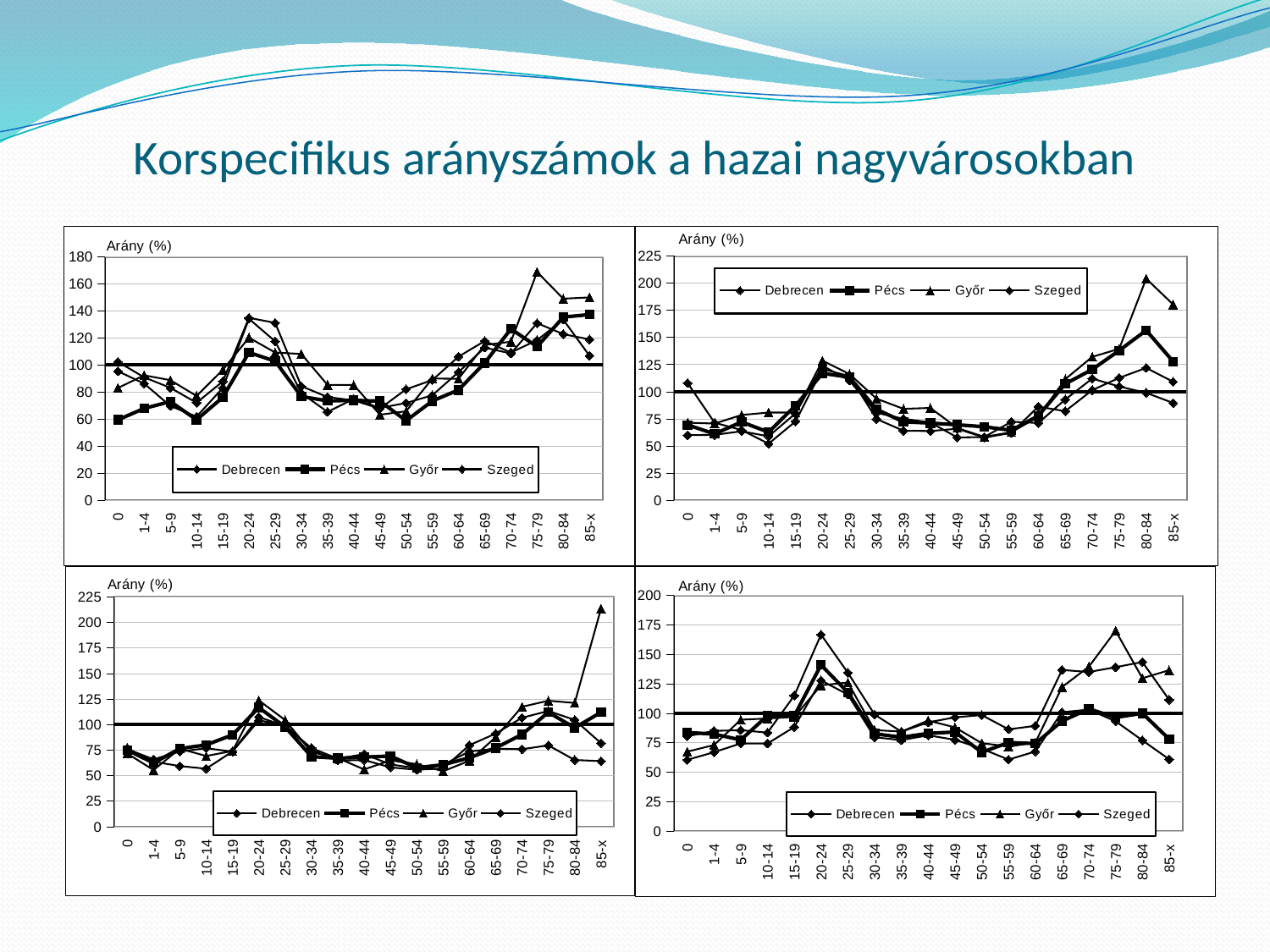
What is the y-axis label of the bottom-right chart? Arány (%) In the top-right chart, is the value for Győr at 80-84 greater or less than 175? greater In the bottom-left chart, which series has the highest value at 85-x? Győr In the top-right chart, which series has the highest value at 80-84? Győr In the top-left chart, which series has the highest value at 75-79? Győr What type of chart is the top-left chart? line chart In the top-left chart, is the value for Győr at 75-79 greater or less than 160? greater In the bottom-left chart, is the value for Győr at 85-x greater or less than 200? greater How many series does the legend of the top-right chart list? 4 How many age categories are shown on the x axis of the bottom-left chart? 19